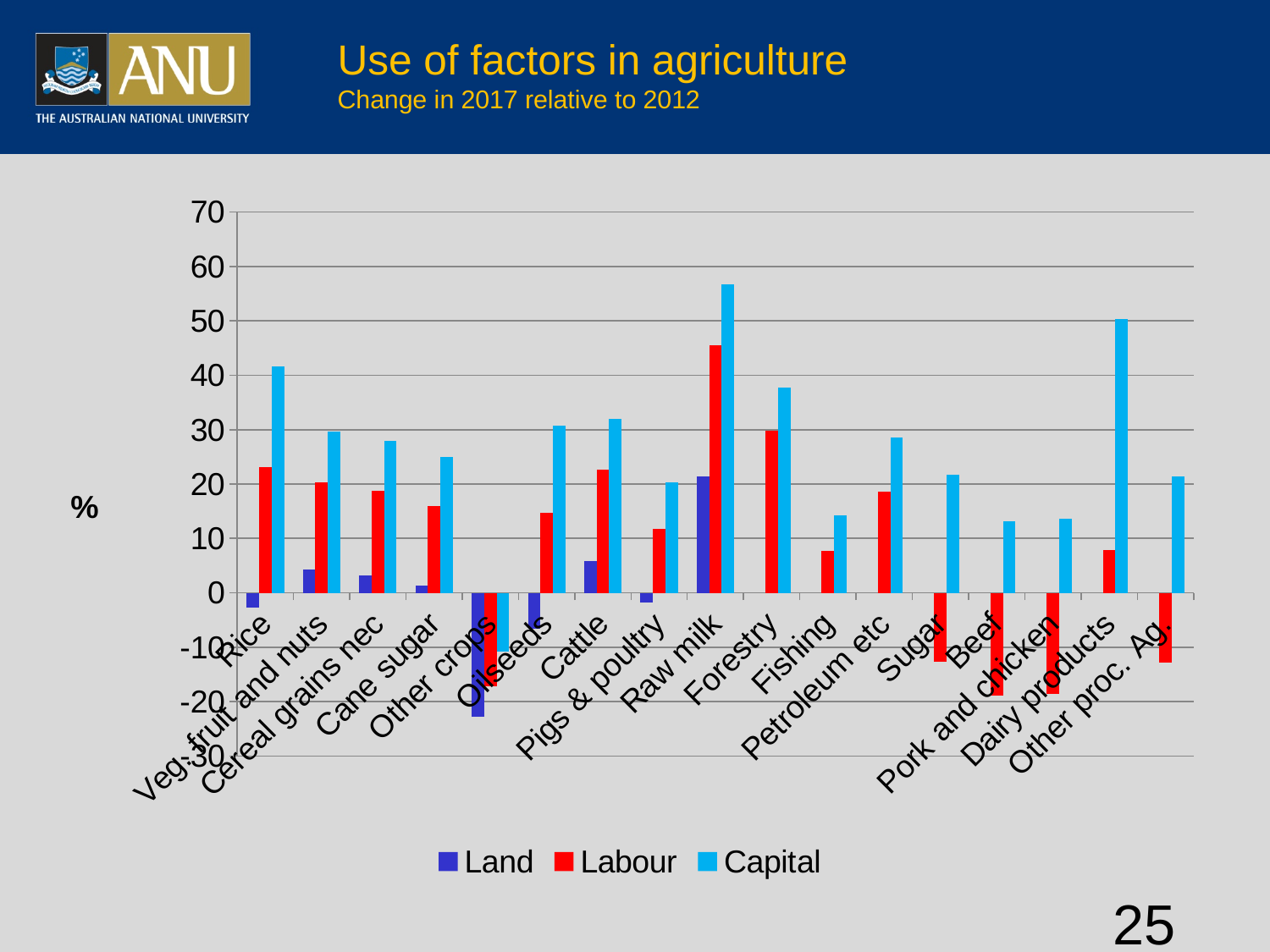
Is the Land value for Other crops greater or less than -20? less How many categories are shown on the x axis? 17 Which is larger: the Land value for Raw milk or the Land value for Cattle? Raw milk Which category has the highest Capital value? Raw milk Which category has the lowest Capital value? Other crops Which category has the lowest Land value? Other crops How many series does the legend list? 3 Is the Labour value for Fishing greater or less than 10? less Is the Capital value for Raw milk greater or less than 50? greater What is the subtitle of the chart? Change in 2017 relative to 2012 Which category has the highest Labour value? Raw milk What kind of chart is shown on the slide? bar chart